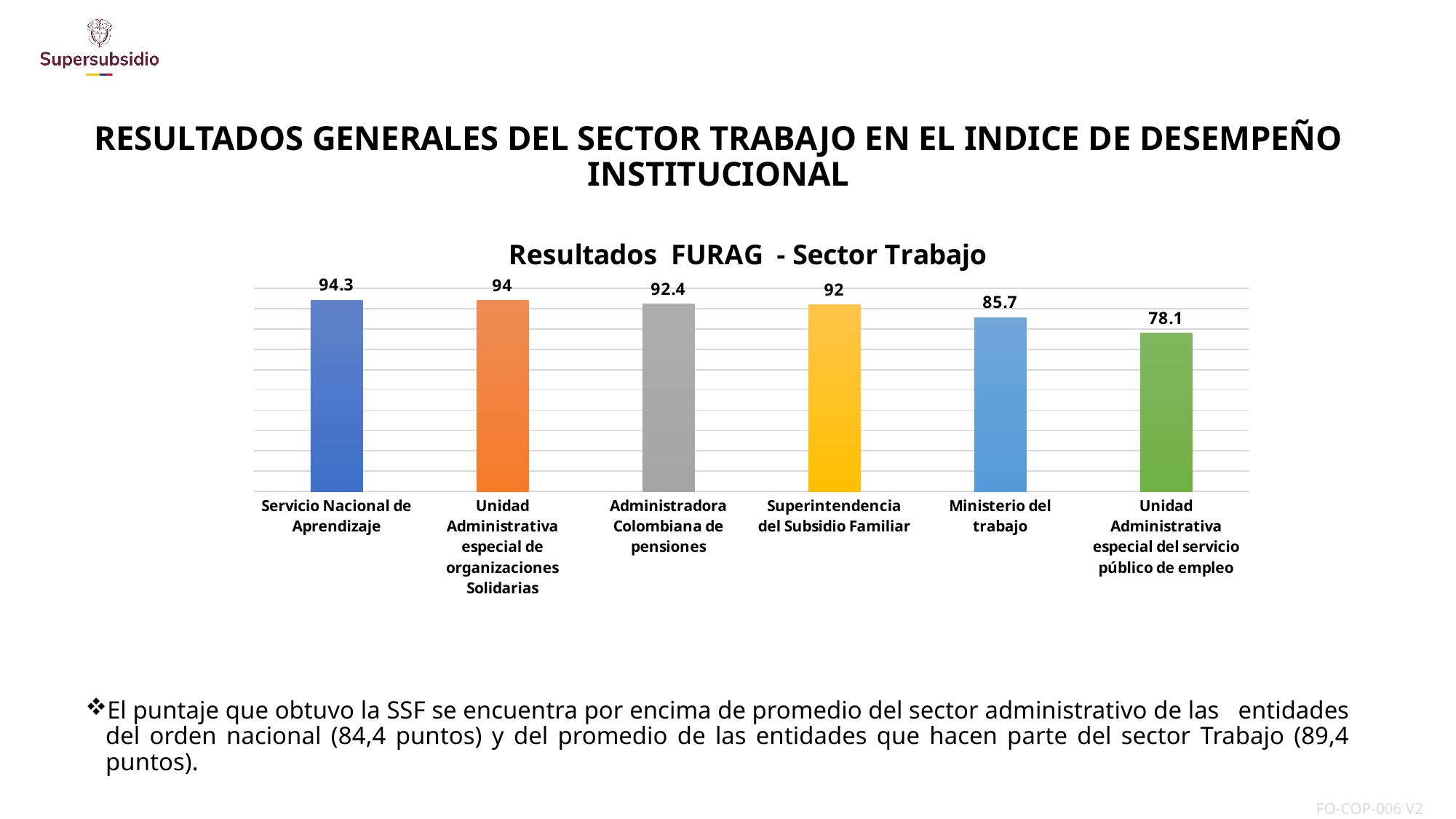
Do the values rise or fall from left to right along the x axis? Fall How many categories are shown in the chart? 6 Which category has the lowest value? Unidad Administrativa especial del servicio público de empleo What kind of chart is shown? Bar chart What is the value for Administradora Colombiana de pensiones? 92.4 Which is larger: the value for Ministerio del trabajo or the value for Superintendencia del Subsidio Familiar? Superintendencia del Subsidio Familiar Which category has the highest value? Servicio Nacional de Aprendizaje What is the value for Ministerio del trabajo? 85.7 What is the title of the chart? Resultados FURAG - Sector Trabajo What is the difference between the values for Servicio Nacional de Aprendizaje and Unidad Administrativa especial del servicio público de empleo? 16.2 What is the value for Servicio Nacional de Aprendizaje? 94.3 What is the value for Superintendencia del Subsidio Familiar? 92